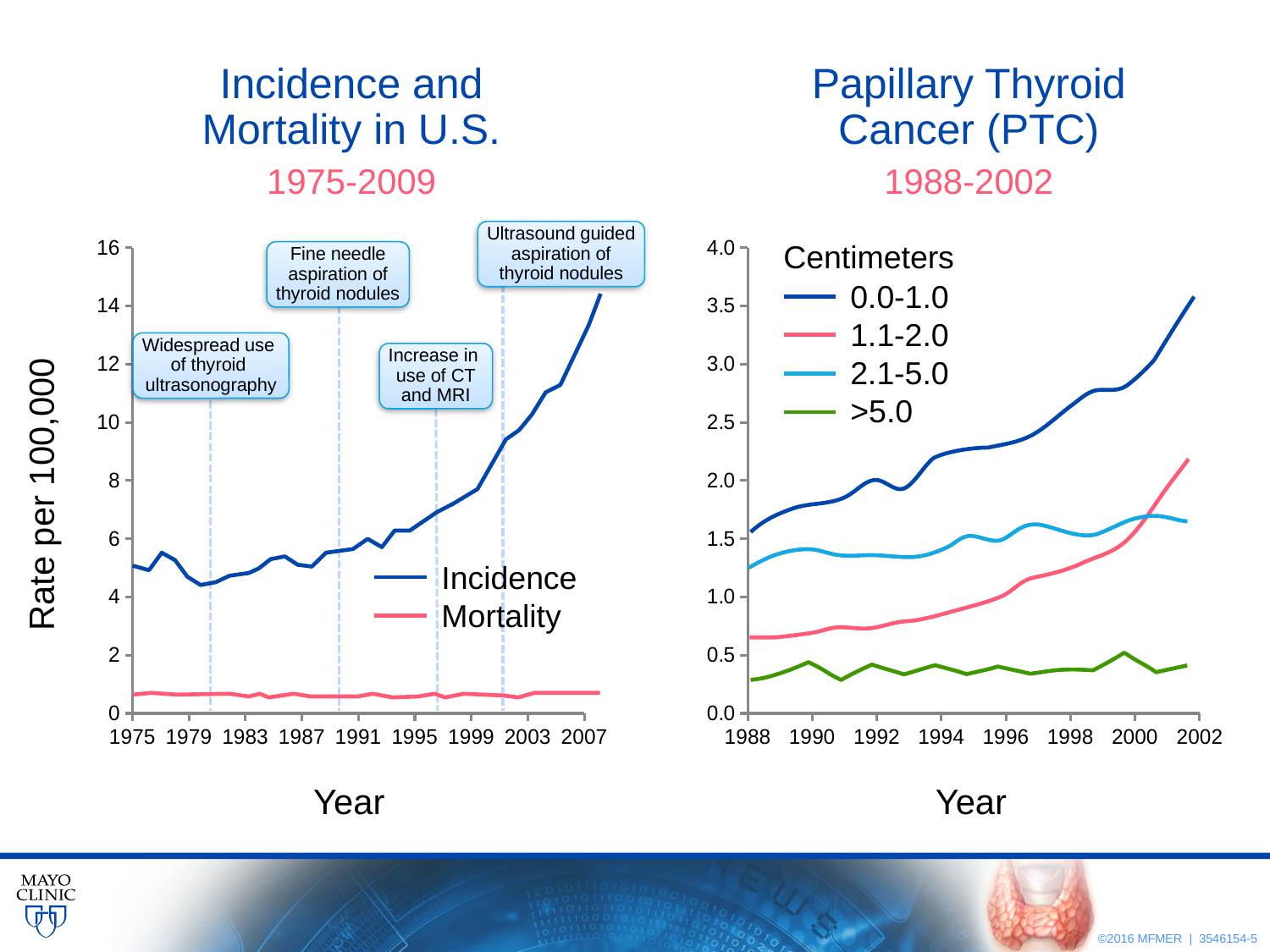
In the 'Incidence and Mortality in U.S.' chart, does the Incidence line rise or fall between 1995 and 2007? rise In the 'Incidence and Mortality in U.S.' chart, is the Incidence value in 2007 greater or less than 12? greater How many series does the legend of the 'Papillary Thyroid Cancer (PTC)' chart list? 4 In the 'Incidence and Mortality in U.S.' chart, which series has the larger value in 2007, Incidence or Mortality? Incidence In the 'Papillary Thyroid Cancer (PTC)' chart, is the value for >5.0 in 2002 greater or less than 1.0? less What is the label on the vertical axis of the 'Incidence and Mortality in U.S.' chart? Rate per 100,000 How many series does the legend of the 'Incidence and Mortality in U.S.' chart list? 2 In the 'Incidence and Mortality in U.S.' chart, is the Mortality value in 2007 greater or less than 2? less In the 'Papillary Thyroid Cancer (PTC)' chart, does the 0.0-1.0 line rise or fall from 1988 to 2002? rise What kind of chart is the 'Incidence and Mortality in U.S.' chart on the left? line chart In the 'Papillary Thyroid Cancer (PTC)' chart, which series has the larger value in 2002, 1.1-2.0 or 2.1-5.0? 1.1-2.0